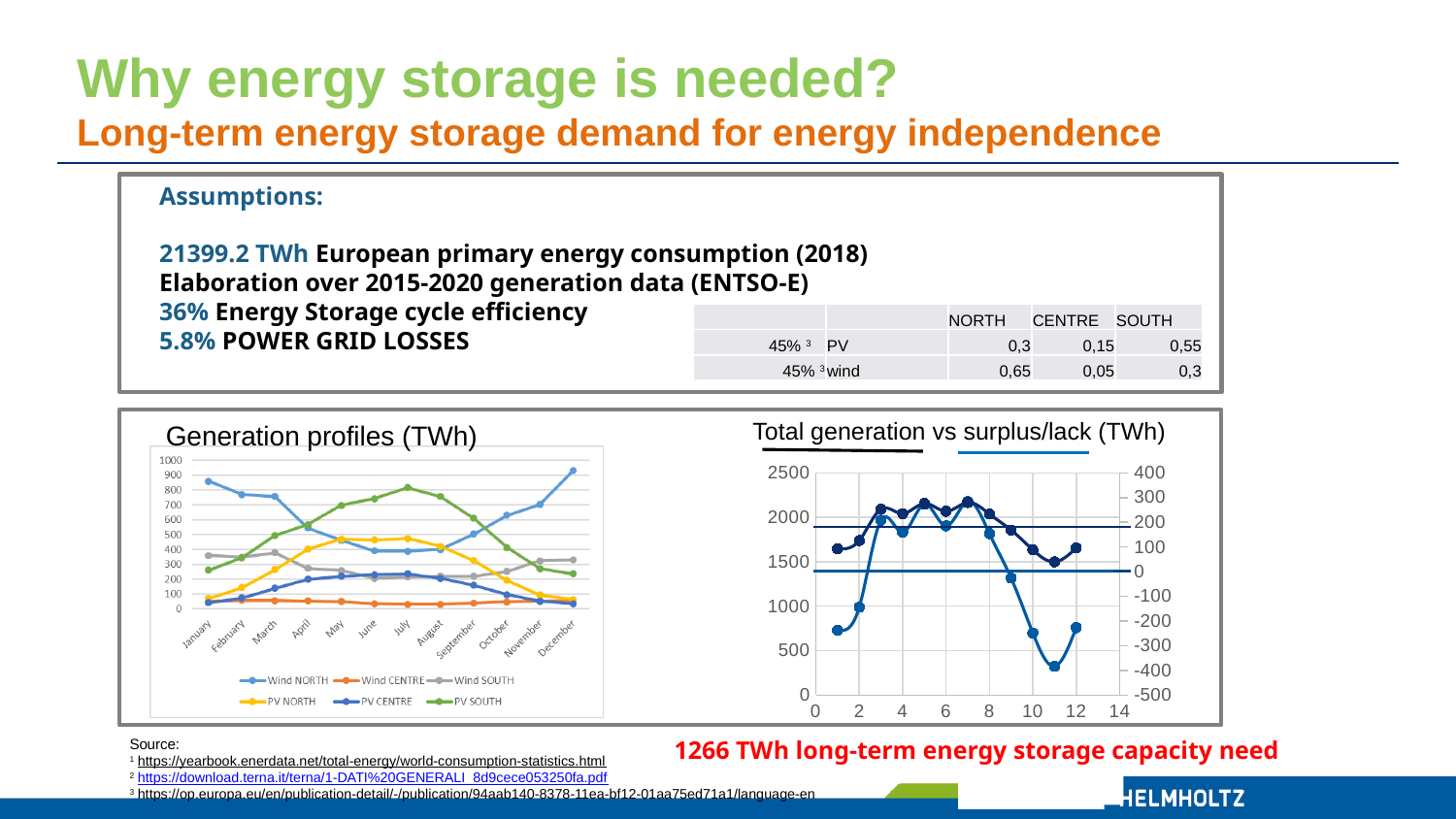
In the 'Generation profiles (TWh)' chart, does Wind NORTH rise or fall from January to July? Fall In the 'Generation profiles (TWh)' chart, is the value for Wind CENTRE in July greater or less than 100? less What kind of chart is the 'Generation profiles (TWh)' chart? Line chart How many series does the legend of the 'Generation profiles (TWh)' chart list? 6 In the 'Generation profiles (TWh)' chart, in which month does PV SOUTH reach its highest value? July How many months are plotted along the x axis of the 'Generation profiles (TWh)' chart? 12 In the 'Generation profiles (TWh)' chart, is the value for Wind NORTH in January greater or less than 800? greater What is the title of the chart on the right side of the slide? Total generation vs surplus/lack (TWh) In the 'Generation profiles (TWh)' chart, which series has the highest value in December? Wind NORTH In the 'Generation profiles (TWh)' chart, does PV SOUTH rise or fall from January to July? Rise In the 'Generation profiles (TWh)' chart, which series has the lowest values across the year? Wind CENTRE In the 'Generation profiles (TWh)' chart, which is larger in July: PV SOUTH or Wind NORTH? PV SOUTH